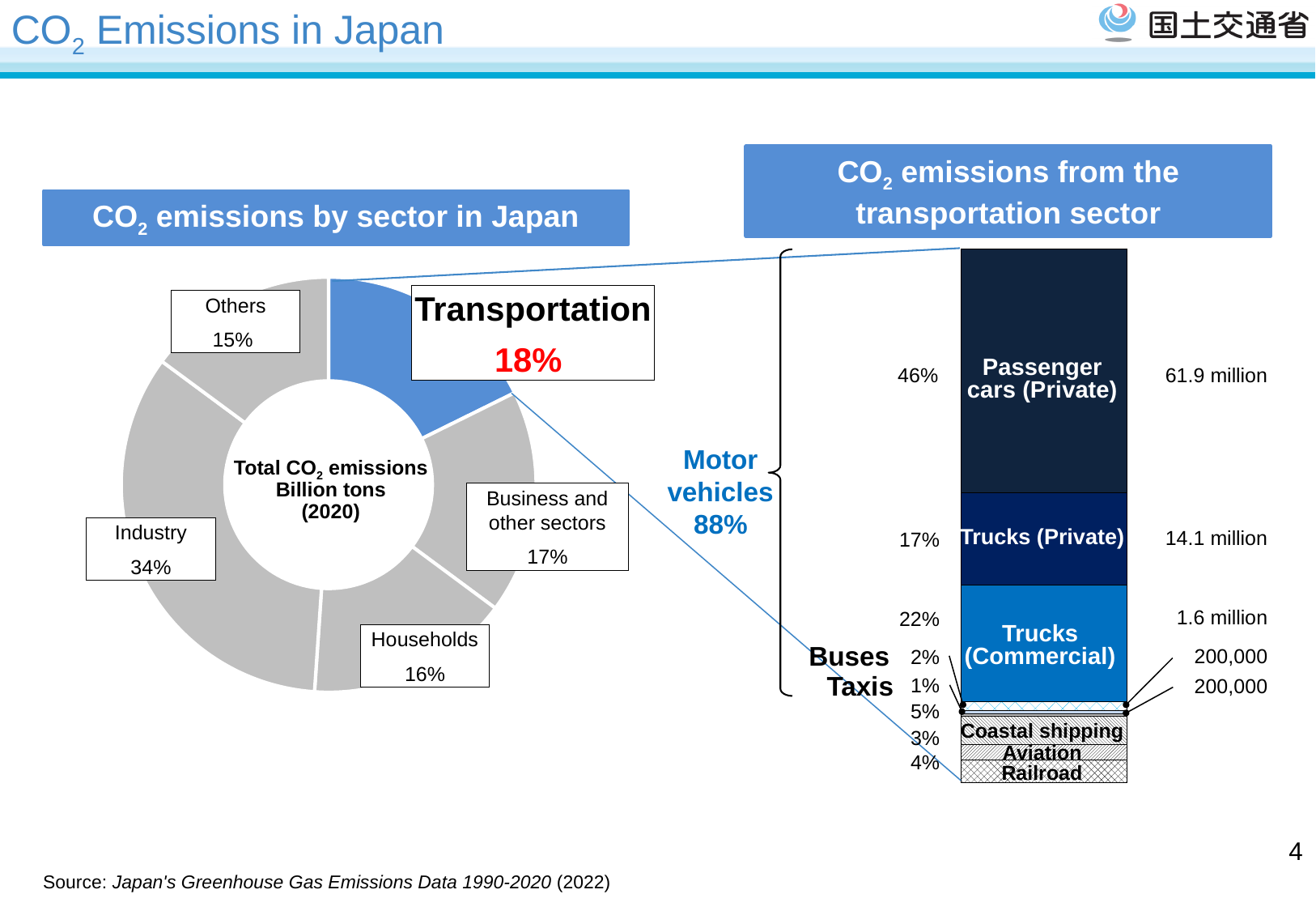
In the 'CO2 emissions from the transportation sector' chart, which category has the smallest percentage? Taxis In the 'CO2 emissions by sector in Japan' chart, what is the difference between the Industry share and the Households share? 18 percentage points In the 'CO2 emissions from the transportation sector' chart, what percentage is attributed to Trucks (Commercial)? 22% In the 'CO2 emissions by sector in Japan' chart, what share of emissions comes from Industry? 34% In the 'CO2 emissions by sector in Japan' chart, what share of emissions comes from Transportation? 18% In the 'CO2 emissions by sector in Japan' chart, which sector has the smallest share? Others In the 'CO2 emissions from the transportation sector' chart, what percentage of emissions comes from motor vehicles in total? 88% What kind of chart is 'CO2 emissions by sector in Japan'? Donut (pie) chart In the 'CO2 emissions from the transportation sector' chart, what is the number shown next to Trucks (Private)? 14.1 million In the 'CO2 emissions by sector in Japan' chart, how many sectors are shown? 5 In the 'CO2 emissions by sector in Japan' chart, which sector has the largest share? Industry In the 'CO2 emissions from the transportation sector' chart, what percentage is attributed to Passenger cars (Private)? 46%